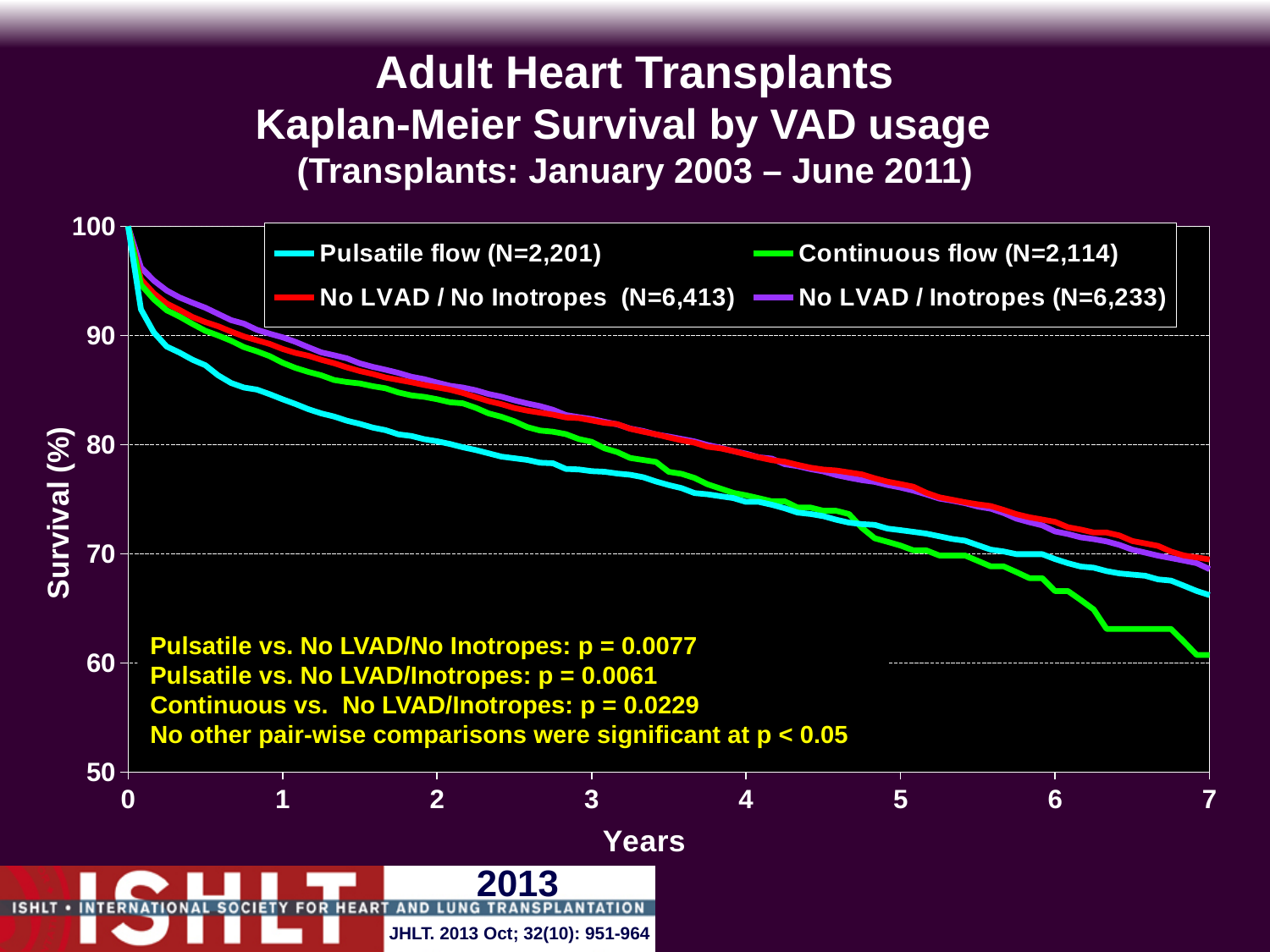
What is the label of the x axis? Years Do the survival curves rise or fall as years increase? Fall What kind of chart is shown on the slide? Line chart How many series does the legend list? 4 At year 6, which series has higher survival: Pulsatile flow or Continuous flow? Pulsatile flow Which series has the lowest survival at year 7? Continuous flow (N=2,114) What is the p-value given for Pulsatile vs. No LVAD/No Inotropes? p = 0.0077 Is the survival for Pulsatile flow at year 3 greater or less than 80? less Is the survival for Continuous flow at year 7 greater or less than 70? less At year 2, which series has higher survival: Continuous flow or Pulsatile flow? Continuous flow Is the survival for Pulsatile flow at year 1 greater or less than 90? less Which series has the lowest survival at year 1? Pulsatile flow (N=2,201)